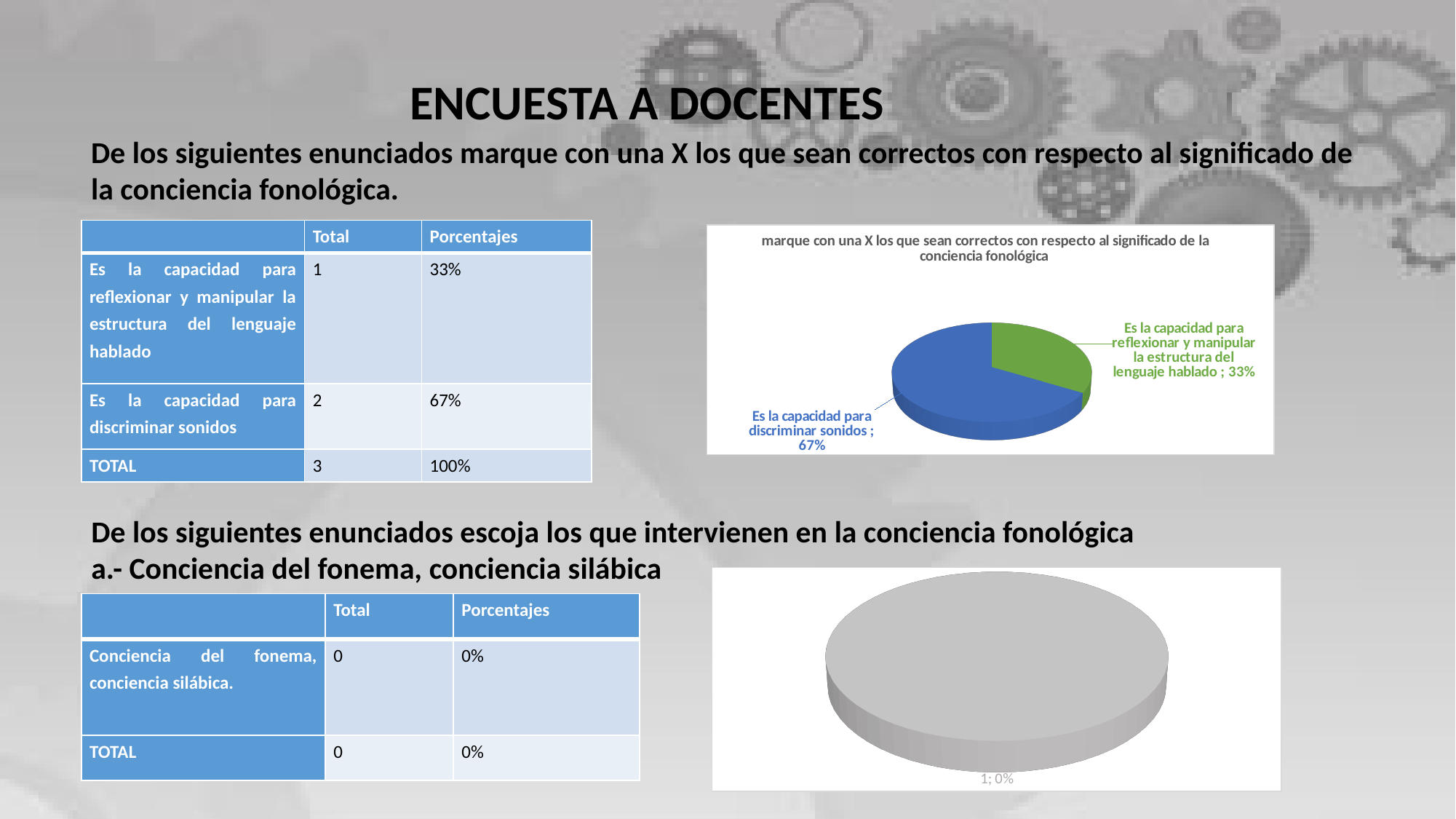
What data label is shown on the bottom pie chart? 1; 0% What is the title of the top pie chart? marque con una X los que sean correctos con respecto al significado de la conciencia fonológica In the top pie chart, which category has the smallest slice? Es la capacidad para reflexionar y manipular la estructura del lenguaje hablado What type of chart is the bottom chart on the slide? Pie chart In the top pie chart, what percentage is shown for "Es la capacidad para reflexionar y manipular la estructura del lenguaje hablado"? 33% In the top pie chart, which is larger: the slice for "Es la capacidad para discriminar sonidos" or the slice for "Es la capacidad para reflexionar y manipular la estructura del lenguaje hablado"? Es la capacidad para discriminar sonidos In the top pie chart, what colour is the slice for "Es la capacidad para discriminar sonidos"? Blue What type of chart is the top chart on the slide? Pie chart In the top pie chart, what percentage is shown for "Es la capacidad para discriminar sonidos"? 67% In the top pie chart, what is the difference in percentage points between the "discriminar sonidos" slice and the "reflexionar y manipular" slice? 34 How many slices does the top pie chart have? 2 In the top pie chart, which category has the largest slice? Es la capacidad para discriminar sonidos